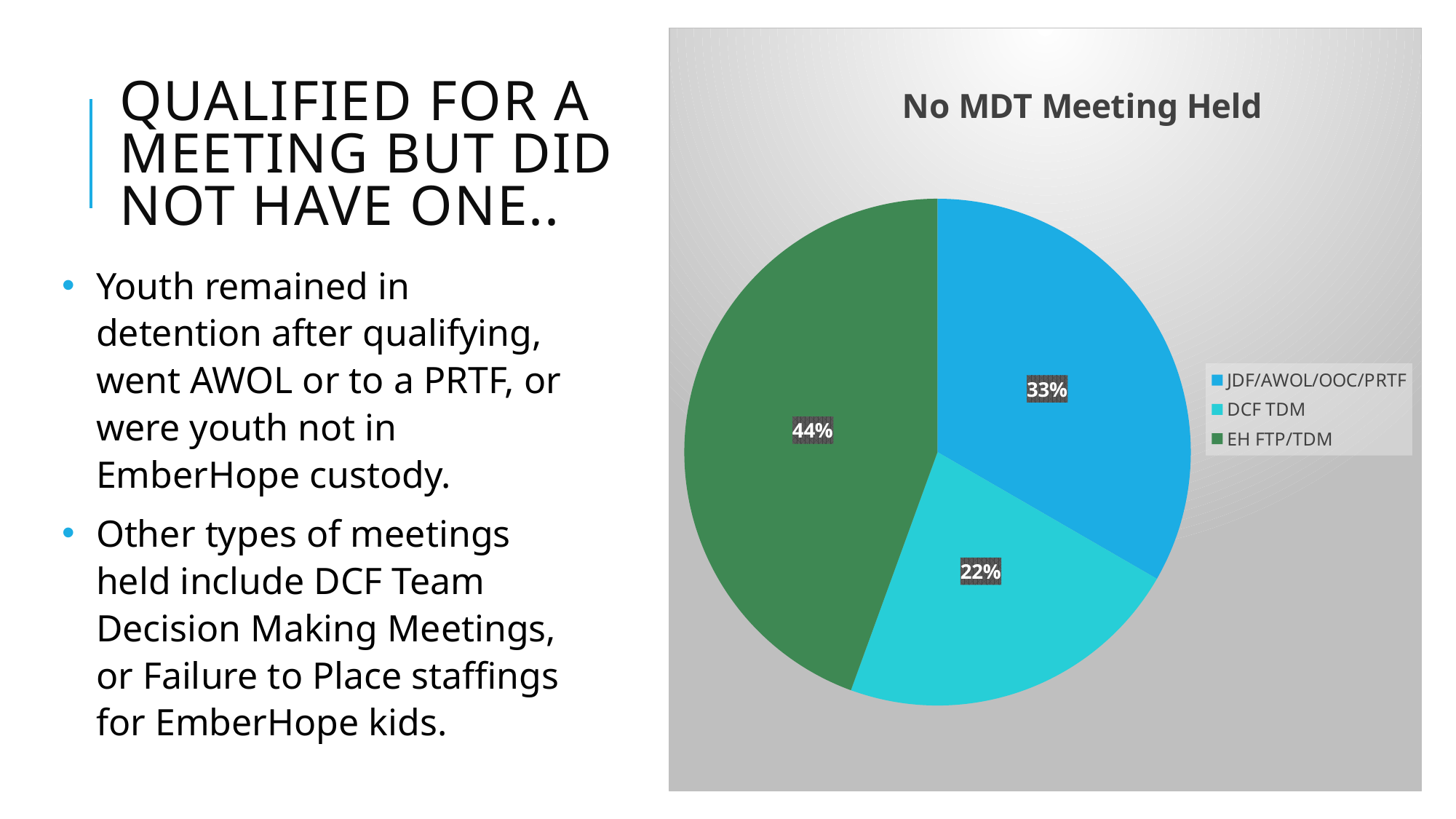
How many categories are shown in the pie chart? 3 Which category has the largest slice of the pie? EH FTP/TDM What share of the pie does JDF/AWOL/OOC/PRTF represent? 33% What share of the pie does EH FTP/TDM represent? 44% Which legend entry is shown in dark green? EH FTP/TDM What is the difference in percentage points between the EH FTP/TDM slice and the DCF TDM slice? 22 What share of the pie does DCF TDM represent? 22% What is the difference in percentage points between the EH FTP/TDM slice and the JDF/AWOL/OOC/PRTF slice? 11 Which category has the smallest slice of the pie? DCF TDM What kind of chart is shown on the slide? Pie chart What is the title of the chart? No MDT Meeting Held Which is larger, the JDF/AWOL/OOC/PRTF slice or the DCF TDM slice? JDF/AWOL/OOC/PRTF